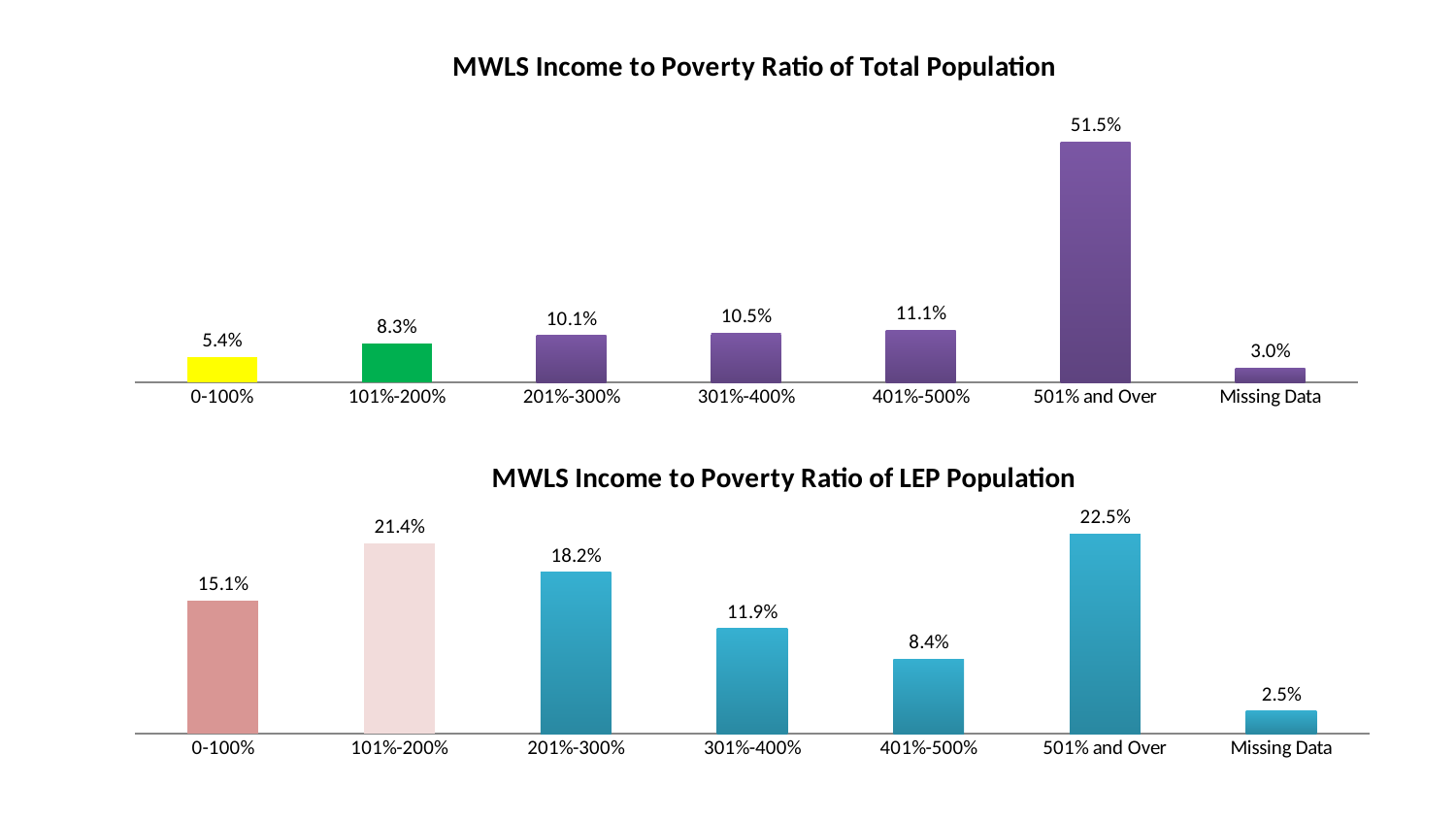
How many categories are shown in the 'MWLS Income to Poverty Ratio of Total Population' chart? 7 In the 'MWLS Income to Poverty Ratio of Total Population' chart, what is the value for 0-100%? 5.4% In the 'MWLS Income to Poverty Ratio of LEP Population' chart, which is larger, the value for 201%-300% or the value for 301%-400%? 201%-300% What kind of chart is the 'MWLS Income to Poverty Ratio of LEP Population' chart? Bar chart In the 'MWLS Income to Poverty Ratio of LEP Population' chart, what is the difference between the values for 0-100% and 401%-500%? 6.7% In the 'MWLS Income to Poverty Ratio of Total Population' chart, do the values rise or fall from 0-100% to 501% and Over? Rise In the 'MWLS Income to Poverty Ratio of LEP Population' chart, which category has the highest value? 501% and Over In the 'MWLS Income to Poverty Ratio of LEP Population' chart, what is the value for 101%-200%? 21.4% In the 'MWLS Income to Poverty Ratio of Total Population' chart, what is the difference between the values for 501% and Over and 401%-500%? 40.4% In the 'MWLS Income to Poverty Ratio of LEP Population' chart, what is the value for Missing Data? 2.5% In the 'MWLS Income to Poverty Ratio of Total Population' chart, what is the value for 501% and Over? 51.5% In the 'MWLS Income to Poverty Ratio of Total Population' chart, which category has the lowest value? Missing Data